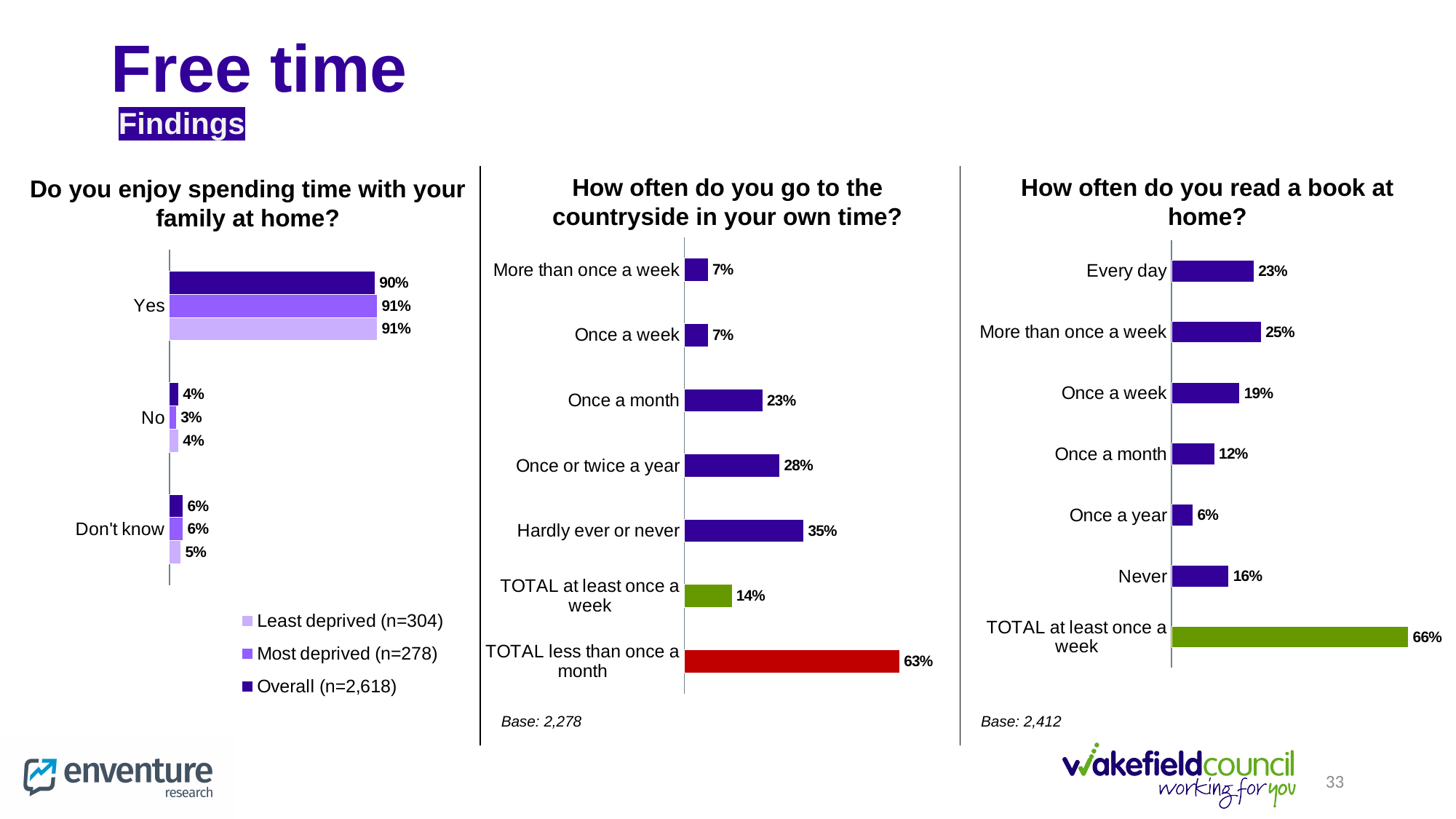
In the chart 'How often do you read a book at home?', which category has the lowest value? Once a year In the chart 'How often do you go to the countryside in your own time?', which is larger: 'Once a month' or 'Once or twice a year'? Once or twice a year In the chart 'How often do you go to the countryside in your own time?', what is the difference between 'Once or twice a year' and 'Once a month'? 5% In the chart 'How often do you read a book at home?', which category has the highest value? TOTAL at least once a week In the chart 'How often do you go to the countryside in your own time?', what is the value for 'Hardly ever or never'? 35% In the chart 'How often do you read a book at home?', what is the value for 'Never'? 16% How many series does the legend list in the chart 'Do you enjoy spending time with your family at home?' 3 In the chart 'Do you enjoy spending time with your family at home?', what is the difference between the Overall values for 'Yes' and 'No'? 86% What type of chart is 'How often do you read a book at home?' Bar chart In the chart 'Do you enjoy spending time with your family at home?', what is the Overall value for 'Yes'? 90% In the chart 'Do you enjoy spending time with your family at home?', what is the Most deprived value for 'No'? 3% In the chart 'How often do you go to the countryside in your own time?', what is the value for 'TOTAL less than once a month'? 63%